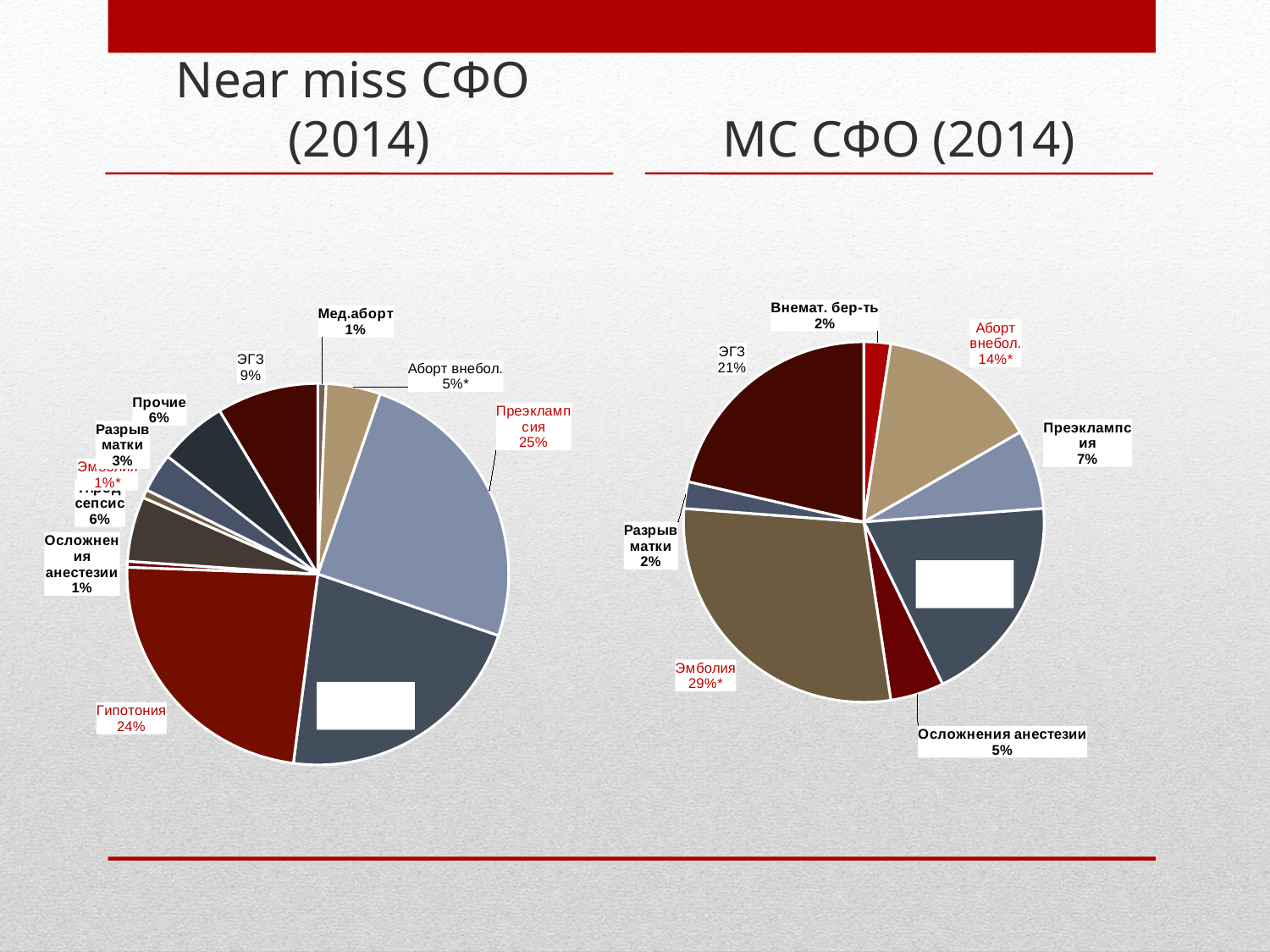
In the Near miss СФО (2014) chart, what is the value for Разрыв матки? 3% In the Near miss СФО (2014) chart, what is the value for Гипотония? 24% In the МС СФО (2014) chart, what is the value for ЭГЗ? 21% In the Near miss СФО (2014) chart, which is larger, Преэклампсия or ЭГЗ? Преэклампсия In the Near miss СФО (2014) chart, what is the difference in percentage points between ЭГЗ and Прочие? 3 percentage points In the Near miss СФО (2014) chart, what is the value for ЭГЗ? 9% In the МС СФО (2014) chart, what is the value for Осложнения анестезии? 5% In the МС СФО (2014) chart, what is the difference in percentage points between Эмболия and ЭГЗ? 8 percentage points In the МС СФО (2014) chart, what is the value for Эмболия? 29%* What type of chart is used for МС СФО (2014)? Pie chart In the МС СФО (2014) chart, which labelled category has the largest share? Эмболия In the Near miss СФО (2014) chart, what share does Преэклампсия have? 25%